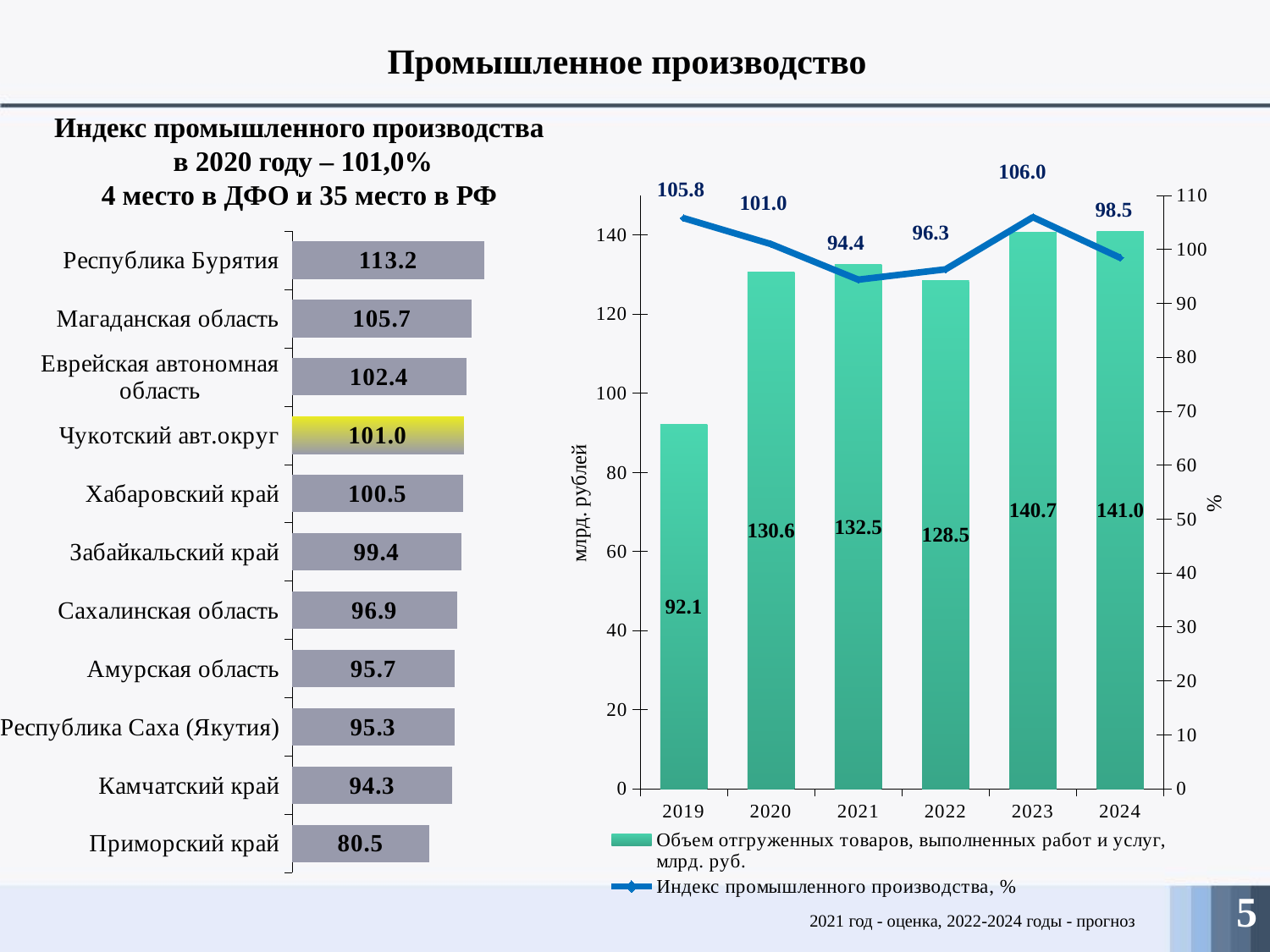
In the left bar chart, which is larger: the value for Сахалинская область or Амурская область? Сахалинская область In the left bar chart, what is the difference between the values for Магаданская область and Камчатский край? 11.4 In the left bar chart, what is the value for Республика Бурятия? 113.2 In the right chart, how many years are shown on the x axis? 6 In the left bar chart, which region has the lowest value? Приморский край In the right chart, what is the value of the bar for 2019? 92.1 In the right chart, how many series does the legend list? 2 In the right chart, what is the difference between the bar values for 2023 and 2022? 12.2 In the left bar chart, how many regions are listed? 11 In the right chart, which year has the highest bar value? 2024 In the right chart, what is the value of the line (Индекс промышленного производства, %) for 2023? 106.0 What type of chart is the left chart? Bar chart